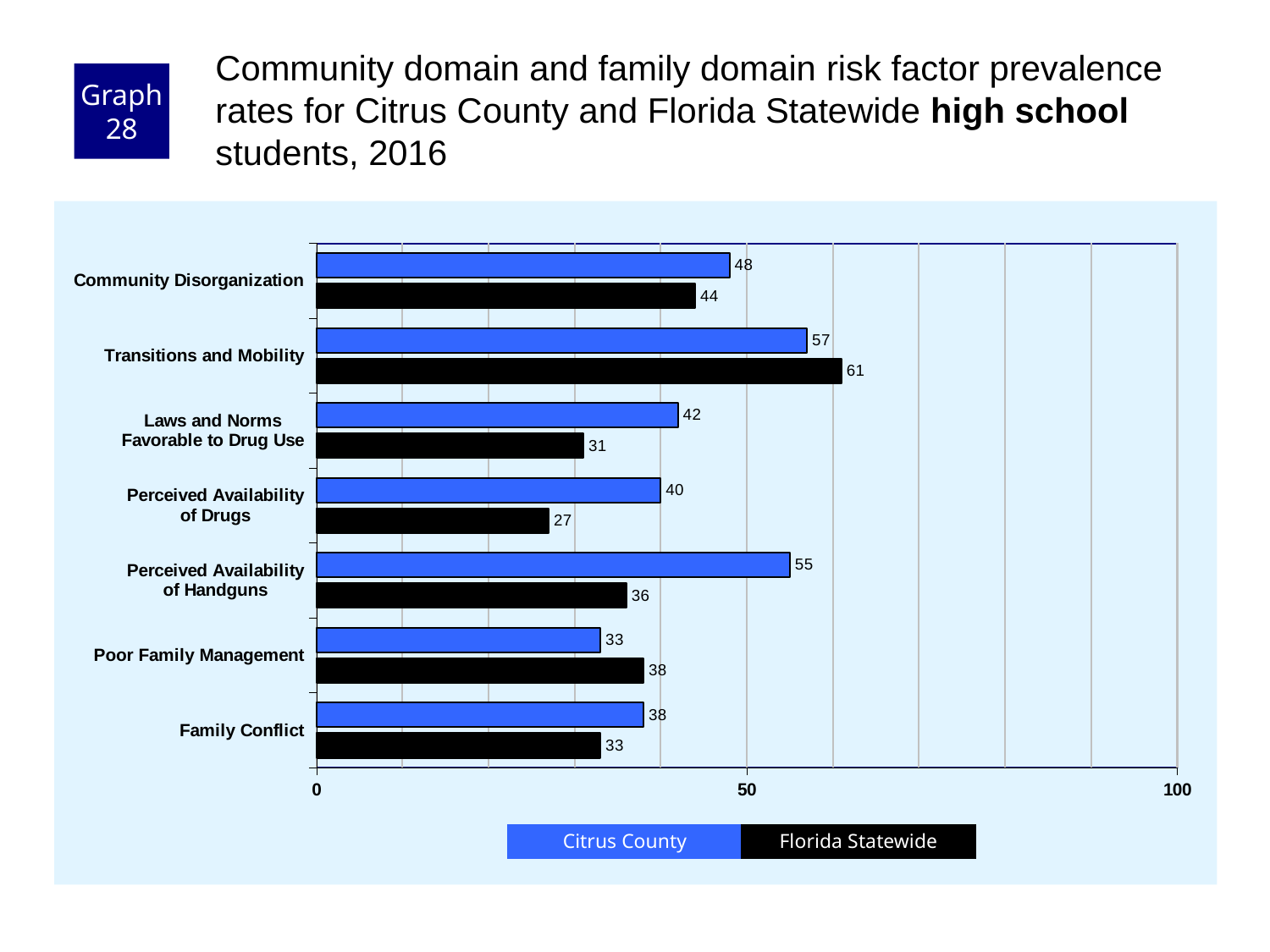
Which risk factor has the highest Citrus County value? Transitions and Mobility What is the Florida Statewide value for Perceived Availability of Drugs? 27 Which colour represents Florida Statewide in the chart? Black What is the Florida Statewide value for Transitions and Mobility? 61 Which risk factor has the lowest Florida Statewide value? Perceived Availability of Drugs How many series does the legend list? 2 What is the Citrus County value for Community Disorganization? 48 What kind of chart is shown on the slide? Bar chart What is the difference between the Citrus County and Florida Statewide values for Perceived Availability of Handguns? 19 Is the Citrus County value for Perceived Availability of Handguns greater or less than 50? greater Which is larger for Poor Family Management: the Citrus County value or the Florida Statewide value? Florida Statewide How many risk factor categories are shown on the chart? 7